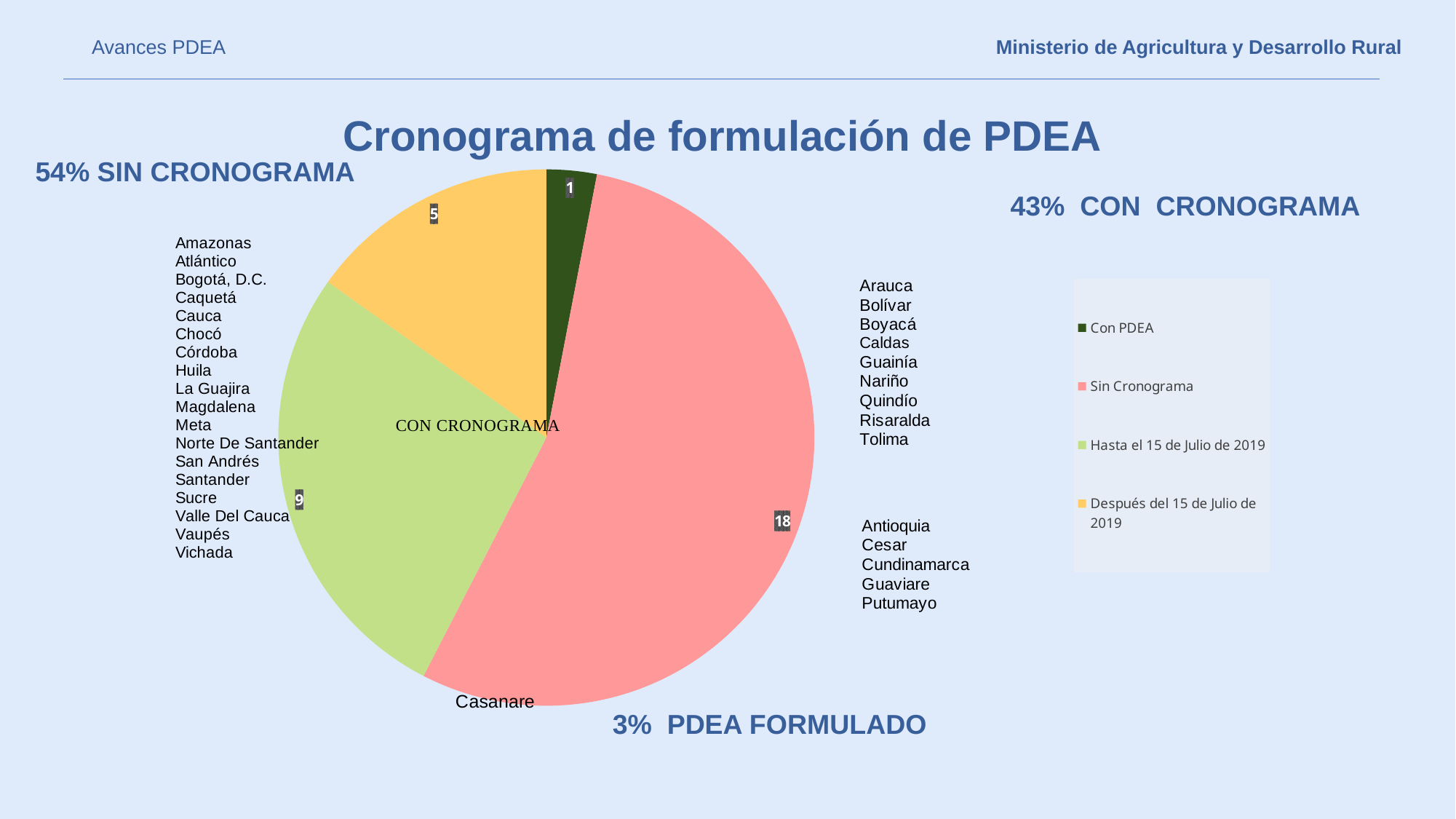
What is the difference between the Sin Cronograma value and the Hasta el 15 de Julio de 2019 value? 9 Which slice has the largest value? Sin Cronograma What is the value for the Con PDEA slice? 1 What is the title of the chart? Cronograma de formulación de PDEA What is the value for the Después del 15 de Julio de 2019 slice? 5 What percentage of the pie does the Sin Cronograma slice represent, as printed on the slide? 54% How many series does the legend list? 4 Which slice has the smallest value? Con PDEA What is the value for the Sin Cronograma slice? 18 What is the value for the Hasta el 15 de Julio de 2019 slice? 9 Which is larger, the Hasta el 15 de Julio de 2019 slice or the Después del 15 de Julio de 2019 slice? Hasta el 15 de Julio de 2019 What kind of chart is shown on the slide? pie chart